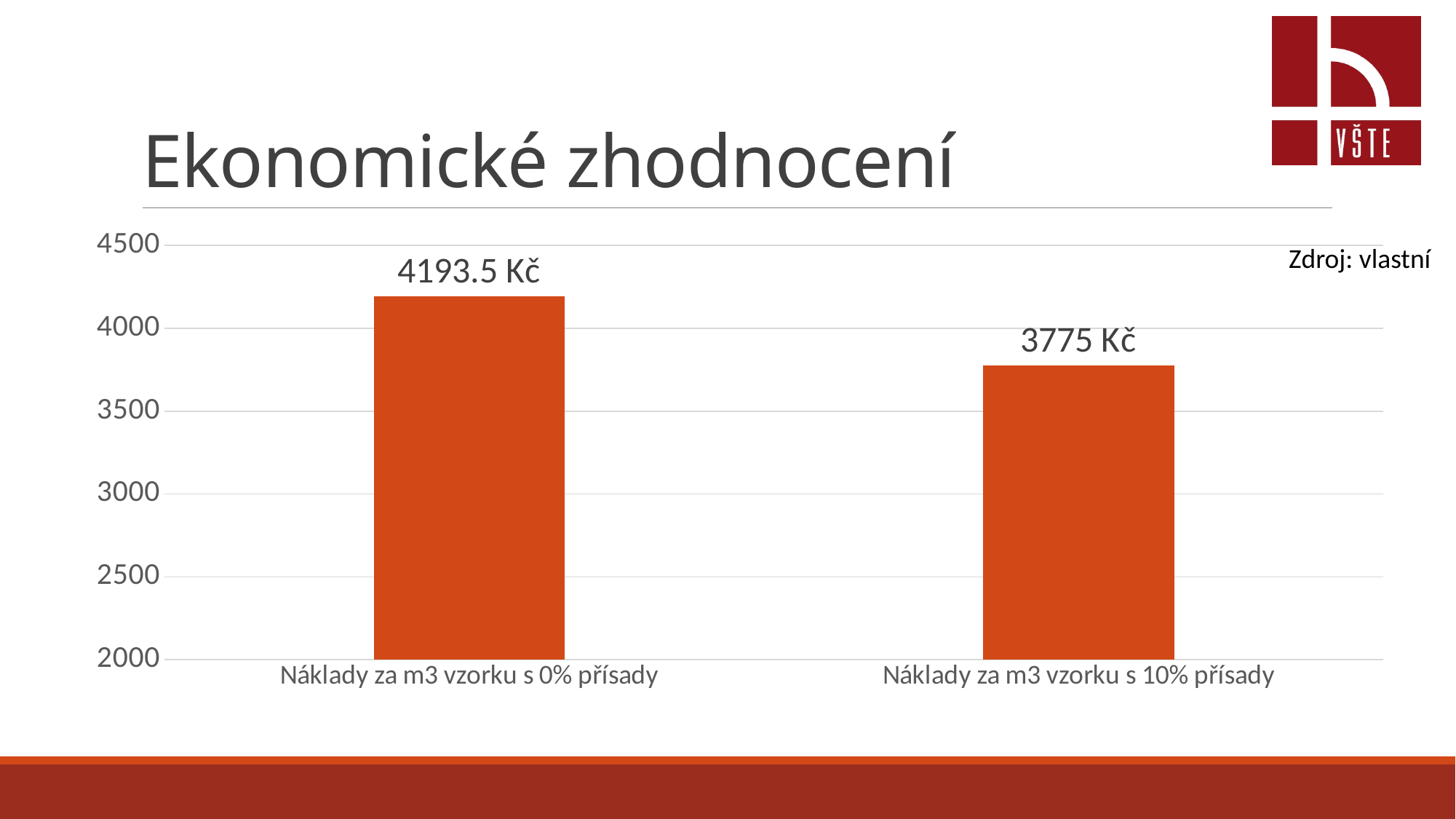
Which category has the lowest value? Náklady za m3 vzorku s 10% přísady What is the value for Náklady za m3 vzorku s 10% přísady? 3775 Kč What is the title of the slide containing the chart? Ekonomické zhodnocení What is the value for Náklady za m3 vzorku s 0% přísady? 4193.5 Kč What is the difference between the value for Náklady za m3 vzorku s 0% přísady and the value for Náklady za m3 vzorku s 10% přísady? 418.5 Kč Do the values rise or fall from the left category to the right category? fall Which is larger: the value for Náklady za m3 vzorku s 0% přísady or the value for Náklady za m3 vzorku s 10% přísady? Náklady za m3 vzorku s 0% přísady Is the value for Náklady za m3 vzorku s 10% přísady greater or less than 4000? less How many categories are shown in the chart? 2 Is the value for Náklady za m3 vzorku s 0% přísady greater or less than 4000? greater Which category has the highest value? Náklady za m3 vzorku s 0% přísady What kind of chart is shown on the slide? bar chart